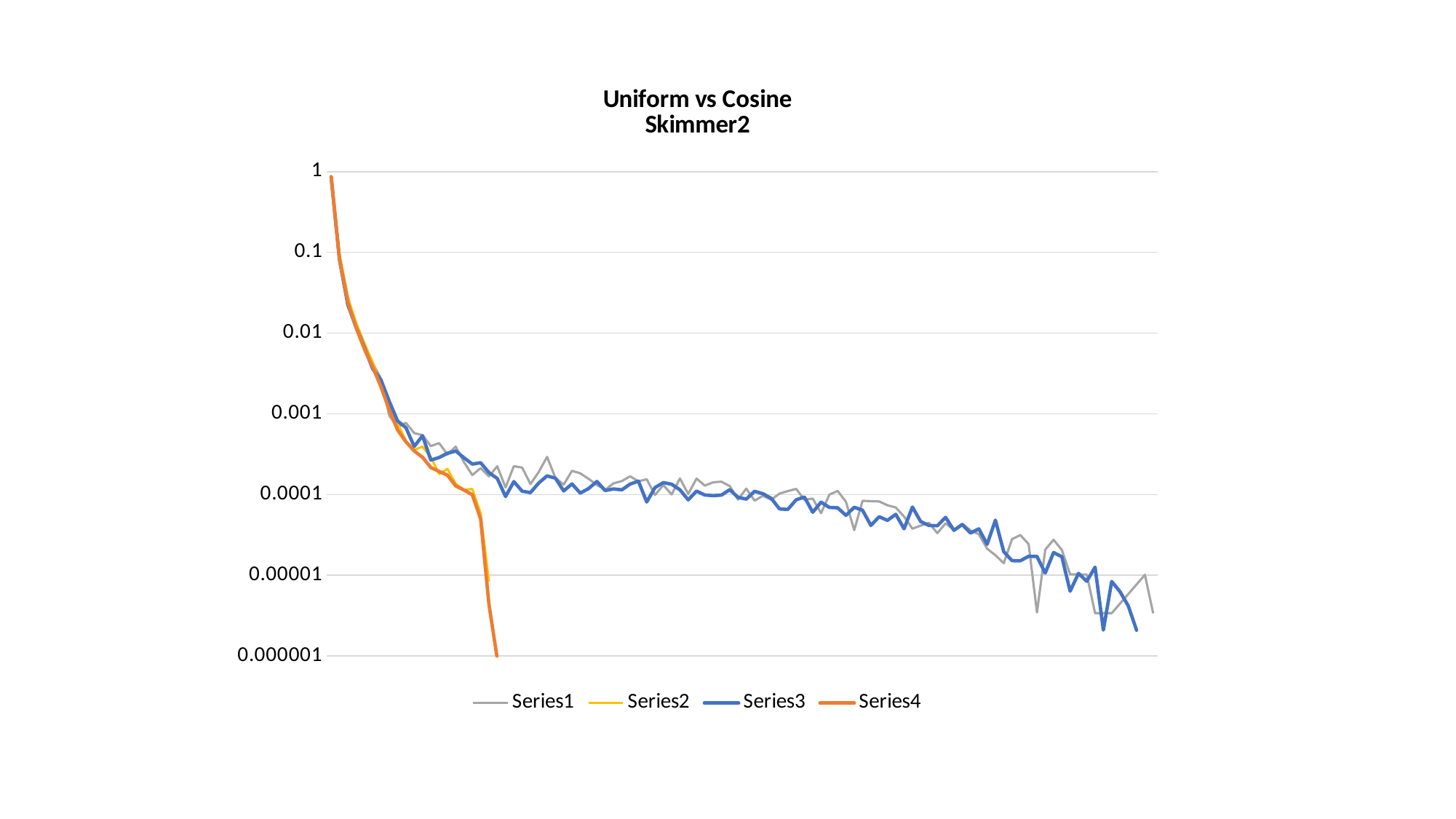
Is the lowest value reached by Series3 greater or less than 0.00001? less How many series drop sharply to the bottom of the chart before reaching the middle of the x axis? 2 What kind of chart is shown on the slide? line chart Is the value at which Series4 ends greater or less than 0.00001? less Is the value of Series3 around the middle of the x axis greater or less than 0.00001? greater Do the plotted values rise or fall as you move from left to right along the x axis? fall How many series does the legend list? 4 What are the names of the series listed in the legend? Series1, Series2, Series3, Series4 What is the title of the chart? Uniform vs Cosine Skimmer2